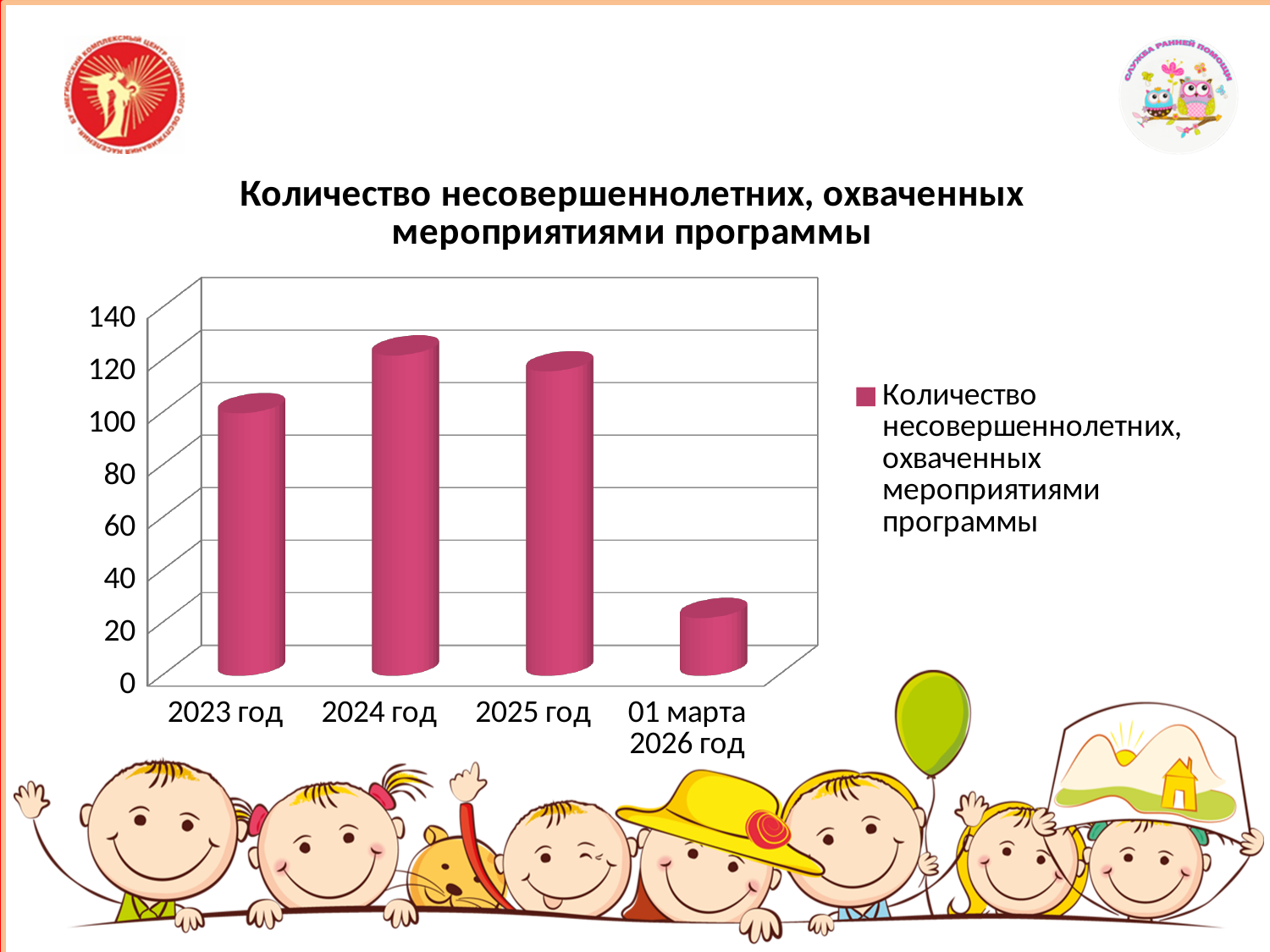
How many categories are shown on the x axis of the chart? 4 Is the value for 2025 год greater or less than 100? greater Does the value rise or fall from 2025 год to 01 марта 2026 год? fall Is the value for 2024 год greater or less than 100? greater What kind of chart is shown on the slide? bar chart Which category has the lowest value in the chart? 01 марта 2026 год What is the title of the chart? Количество несовершеннолетних, охваченных мероприятиями программы Is the value for 2023 год greater or less than 80? greater How many series does the chart legend list? 1 Which is larger, the value for 2023 год or the value for 2024 год? 2024 год Which is larger, the value for 2025 год or the value for 01 марта 2026 год? 2025 год